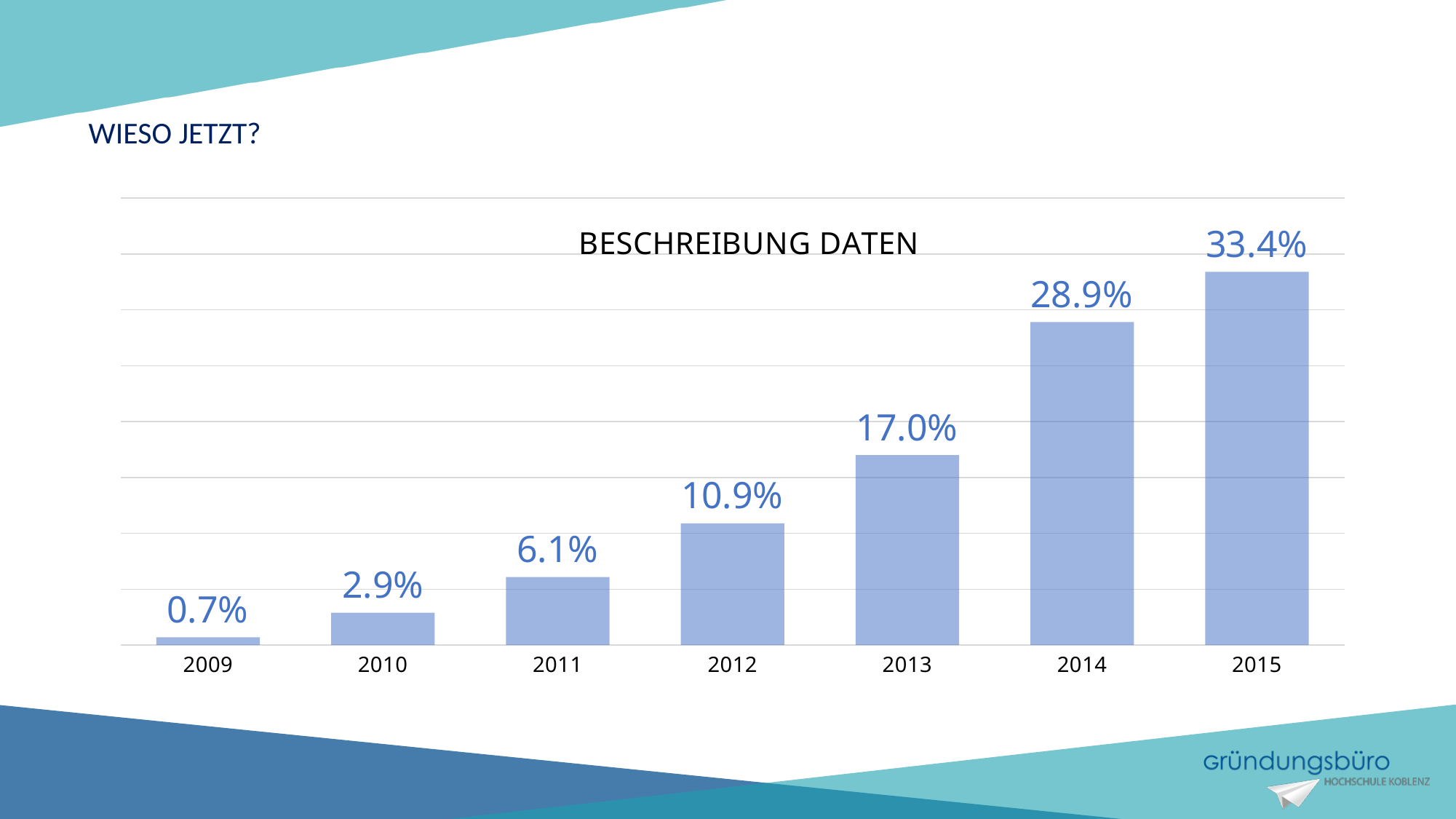
Which is larger, the value for 2011 or the value for 2012? 2012 Which year has the lowest value? 2009 Do the values rise or fall from 2009 to 2015? Rise What kind of chart is shown? Bar chart How many years are shown on the x axis? 7 What is the difference between the values for 2015 and 2014? 4.5% What is the title of the chart? BESCHREIBUNG DATEN What is the value for 2014? 28.9% What is the value for 2009? 0.7% Which year has the highest value? 2015 What is the difference between the values for 2013 and 2011? 10.9% What is the value for 2012? 10.9%